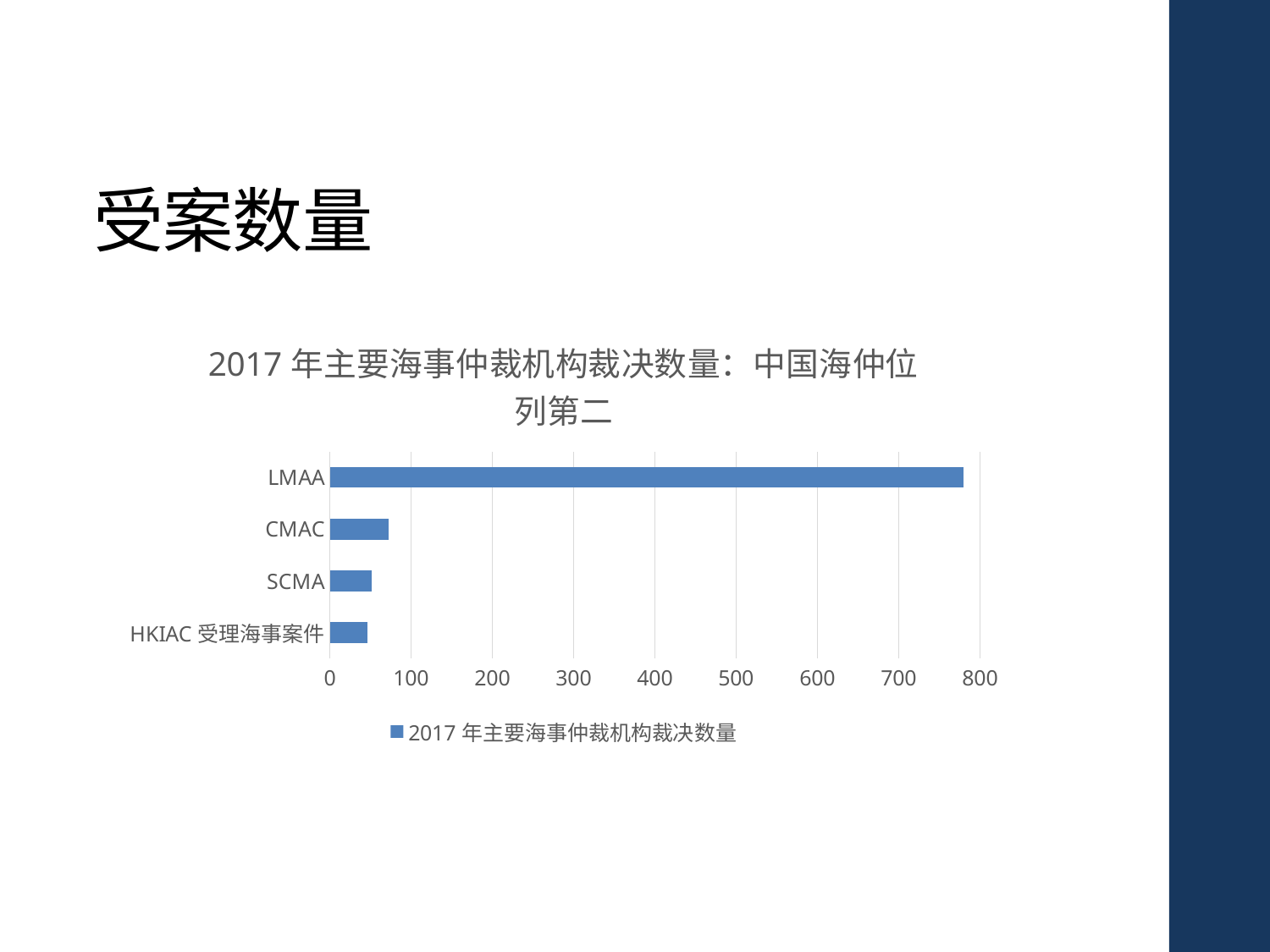
Is the value for SCMA greater or less than 100? less Which has the larger value, CMAC or SCMA? CMAC Which category has the highest value in the chart? LMAA Which has the larger value, LMAA or CMAC? LMAA How many categories are plotted in the chart? 4 How many series does the legend list? 1 Is the value for CMAC greater or less than 100? less Is the value for LMAA greater or less than 700? greater What kind of chart is shown on the slide? Bar chart What is the title of the chart? 2017 年主要海事仲裁机构裁决数量：中国海仲位列第二 What is the legend entry shown below the chart? 2017 年主要海事仲裁机构裁决数量